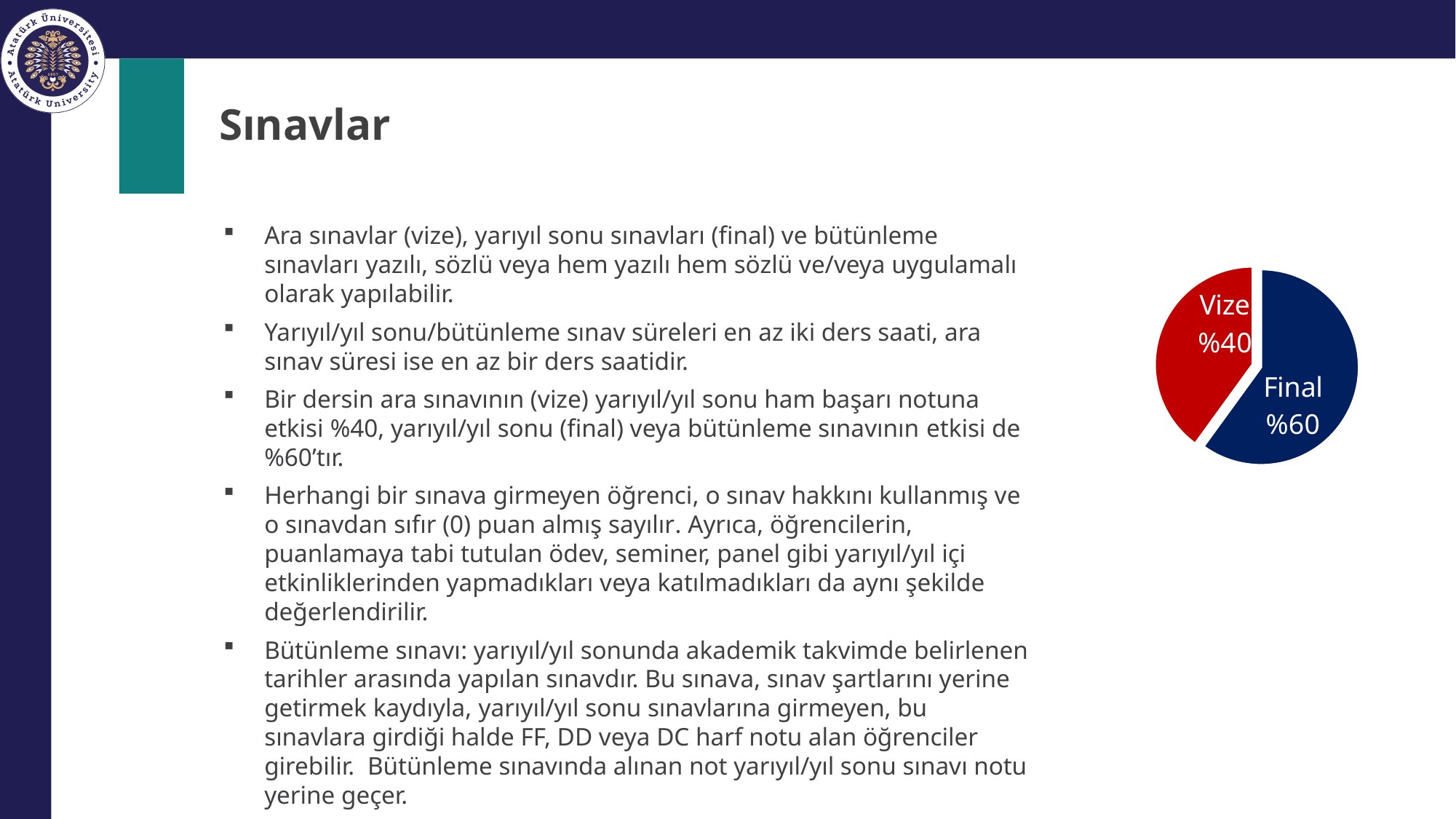
What is the value shown for the Final slice of the pie chart? %60 What colour is the Final slice in the pie chart? dark blue What share of the pie does the Final slice represent? %60 How many slices does the pie chart have? 2 What kind of chart is shown on the slide? pie chart What colour is the Vize slice in the pie chart? red Which is larger in the pie chart, Vize or Final? Final Which slice of the pie chart is the smallest? Vize What is the value shown for the Vize slice of the pie chart? %40 Which slice of the pie chart is the largest? Final What is the difference between the Final and Vize values in the pie chart? %20